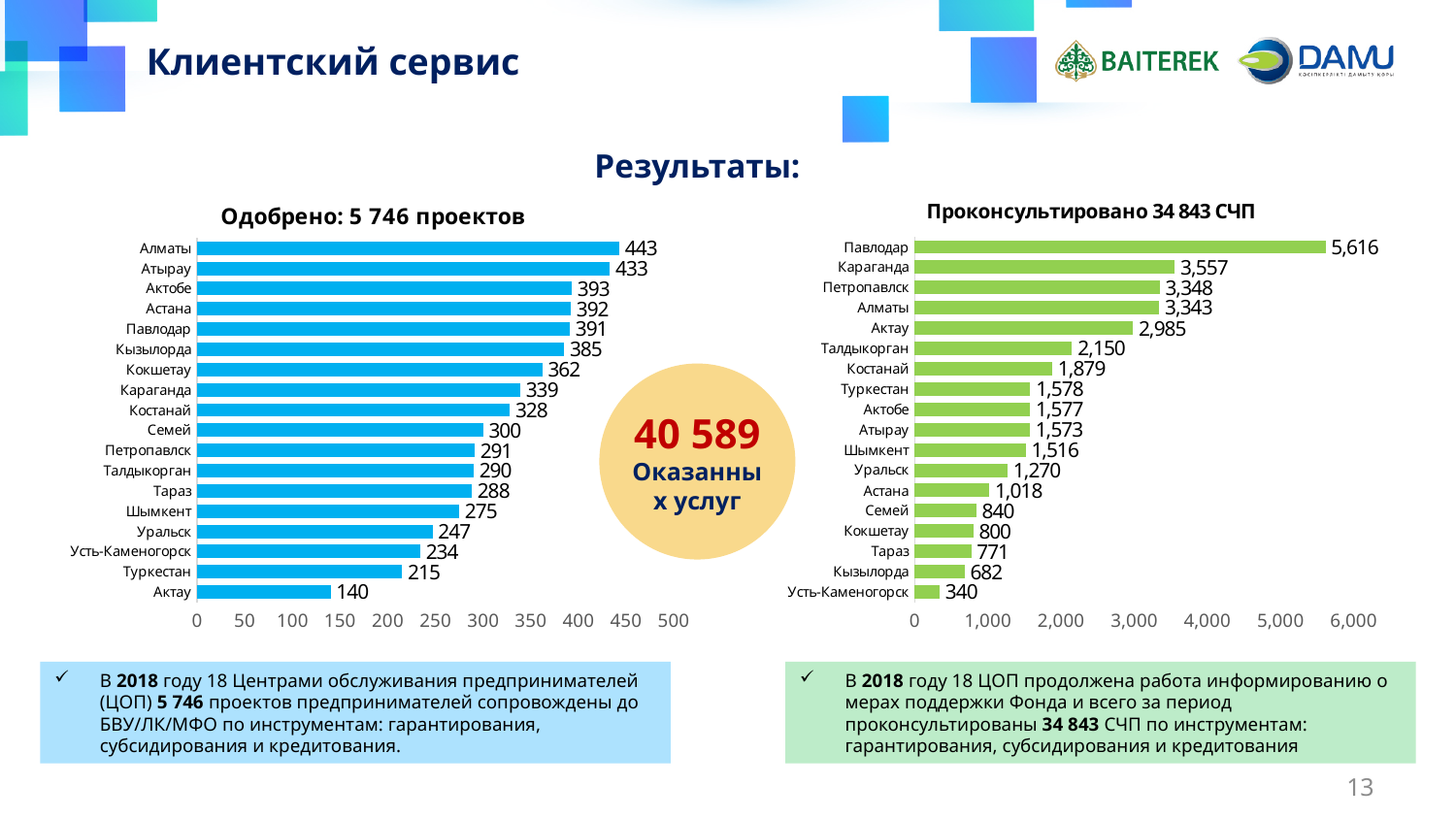
In the chart 'Проконсультировано 34 843 СЧП', which category has the lowest value? Усть-Каменогорск In the chart 'Проконсультировано 34 843 СЧП', which category has the highest value? Павлодар In the chart 'Проконсультировано 34 843 СЧП', what is the difference between the values for Павлодар and Караганда? 2,059 What kind of chart is 'Проконсультировано 34 843 СЧП'? Bar chart In the chart 'Одобрено: 5 746 проектов', which category has the lowest value? Актау In the chart 'Одобрено: 5 746 проектов', what is the difference between the values for Алматы and Актау? 303 In the chart 'Проконсультировано 34 843 СЧП', which is larger, the value for Караганда or the value for Актау? Караганда What number is shown in the yellow circle between the two charts? 40 589 In the chart 'Одобрено: 5 746 проектов', which category has the highest value? Алматы In the chart 'Проконсультировано 34 843 СЧП', what is the value for Талдыкорган? 2,150 In the chart 'Одобрено: 5 746 проектов', what is the value for Кокшетау? 362 In the chart 'Одобрено: 5 746 проектов', how many categories are shown? 18